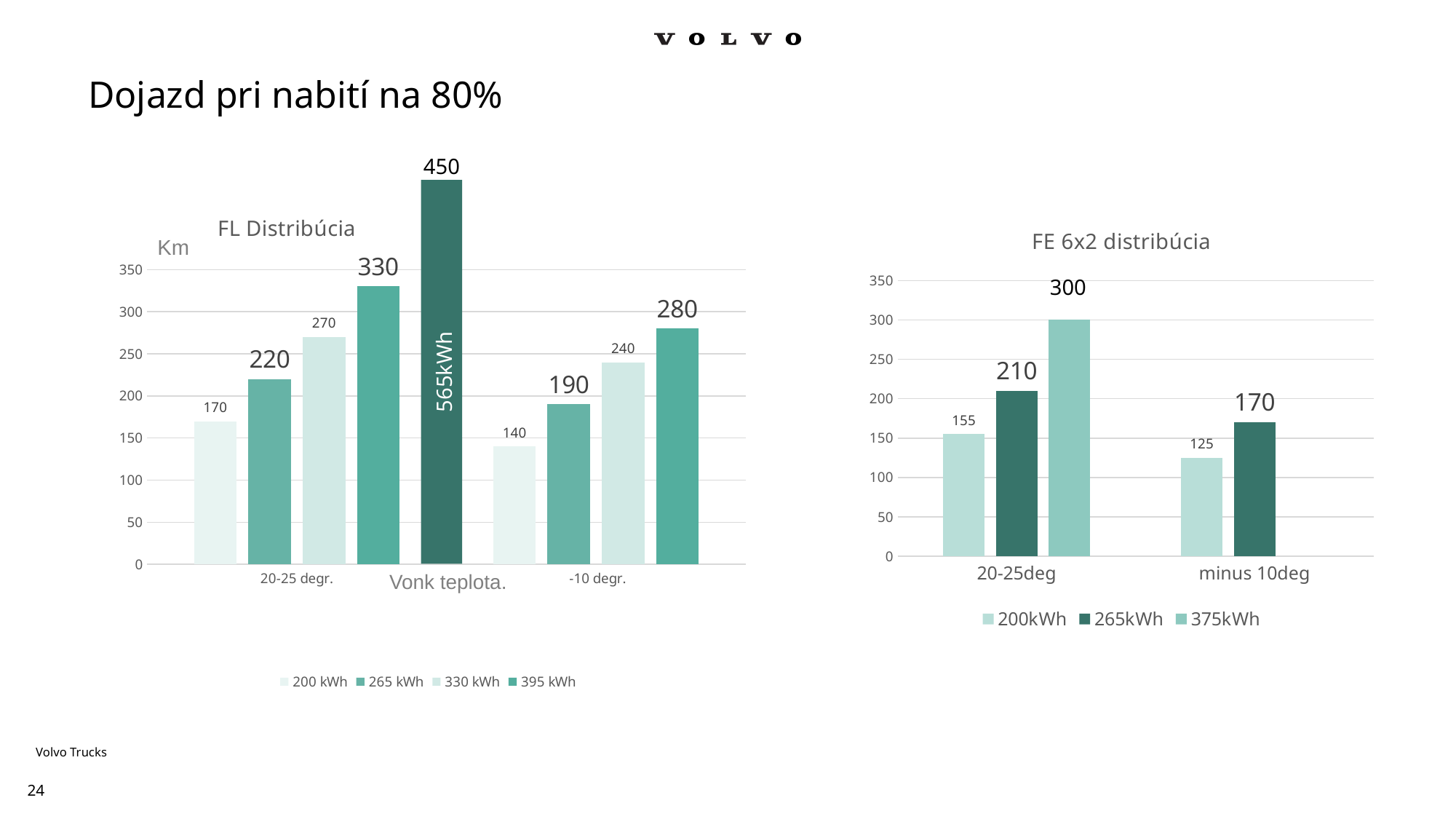
In the FL Distribúcia chart, what is the value of the 200 kWh bar at 20-25 degr.? 170 In the FL Distribúcia chart, what value is shown on the bar labelled 565kWh? 450 In the FL Distribúcia chart, what is the value of the 395 kWh bar at -10 degr.? 280 In the FE 6x2 distribúcia chart, what is the value of the 200kWh bar at minus 10deg? 125 In the FE 6x2 distribúcia chart, which is larger: the 200kWh bar at 20-25deg or the 265kWh bar at minus 10deg? 265kWh at minus 10deg How many series does the legend of the FL Distribúcia chart list? 4 In the FL Distribúcia chart, what is the difference between the 330 kWh values at 20-25 degr. and -10 degr.? 30 In the FE 6x2 distribúcia chart, what is the value of the 375kWh bar at 20-25deg? 300 What type of chart is the FE 6x2 distribúcia chart? Bar chart In the FE 6x2 distribúcia chart, what is the difference between the 265kWh values at 20-25deg and minus 10deg? 40 In the FL Distribúcia chart, which bar has the lowest value? 200 kWh at -10 degr. How many series does the legend of the FE 6x2 distribúcia chart list? 3